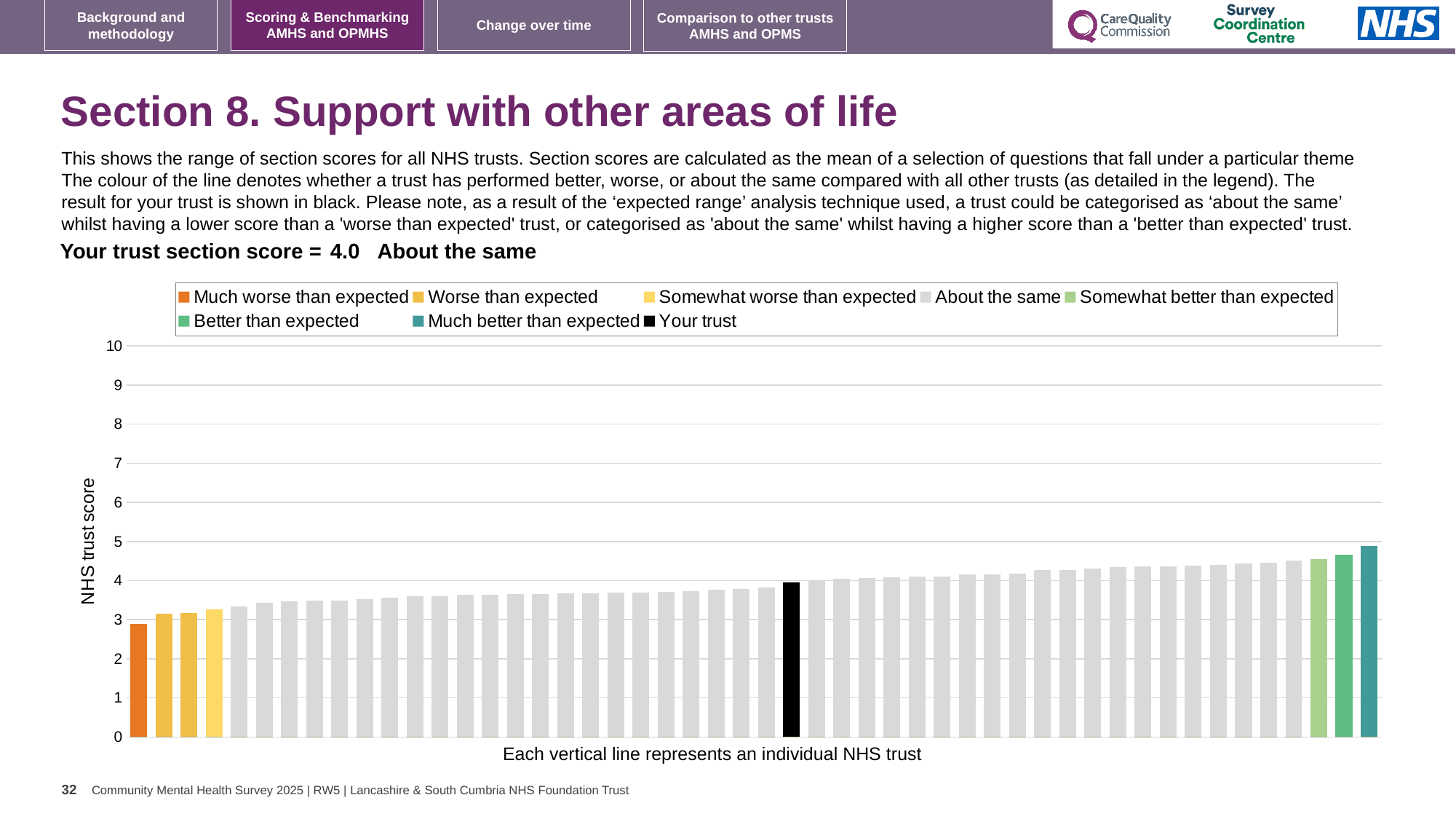
What is the section score for your trust shown on the slide? 4.0 Is the value for Your trust greater or less than 3? greater Which category is your trust placed in for this section? About the same What kind of chart is shown on the slide? bar chart Is the value for Your trust greater or less than 5? less How many entries does the chart legend list? 8 Which is larger: the bar for Your trust or the orange 'Much worse than expected' bar? Your trust Is the lowest bar on the chart greater or less than 2? greater Do the bar values rise or fall from left to right across the chart? rise Which legend category does the highest bar on the chart belong to? Much better than expected Which legend category does the lowest bar on the chart belong to? Much worse than expected What is the label on the vertical axis of the chart? NHS trust score